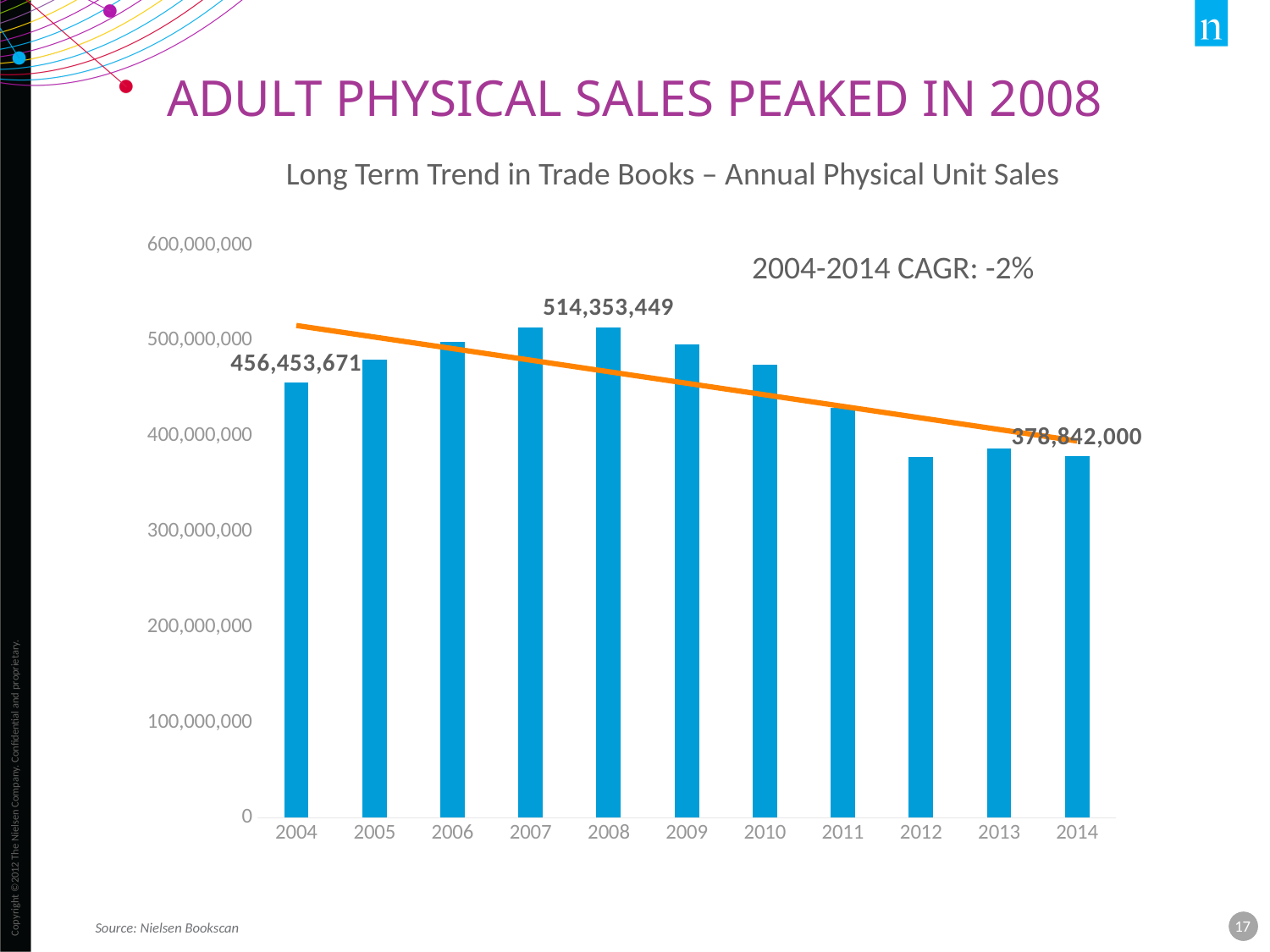
Is the value for 2012 greater or less than 400,000,000? less What is the value for 2004? 456,453,671 Is the value for 2010 greater or less than 500,000,000? less How many years are shown on the x axis? 11 Which year has the highest annual physical unit sales? 2008 What is the value for 2014? 378,842,000 What is the value for 2008? 514,353,449 Which is larger, the value for 2004 or the value for 2014? 2004 What is the difference between the 2008 value and the 2014 value? 135,511,449 What is the difference between the 2008 value and the 2004 value? 57,899,778 What kind of chart is shown on the slide? bar chart What is the 2004-2014 CAGR stated on the chart? -2%